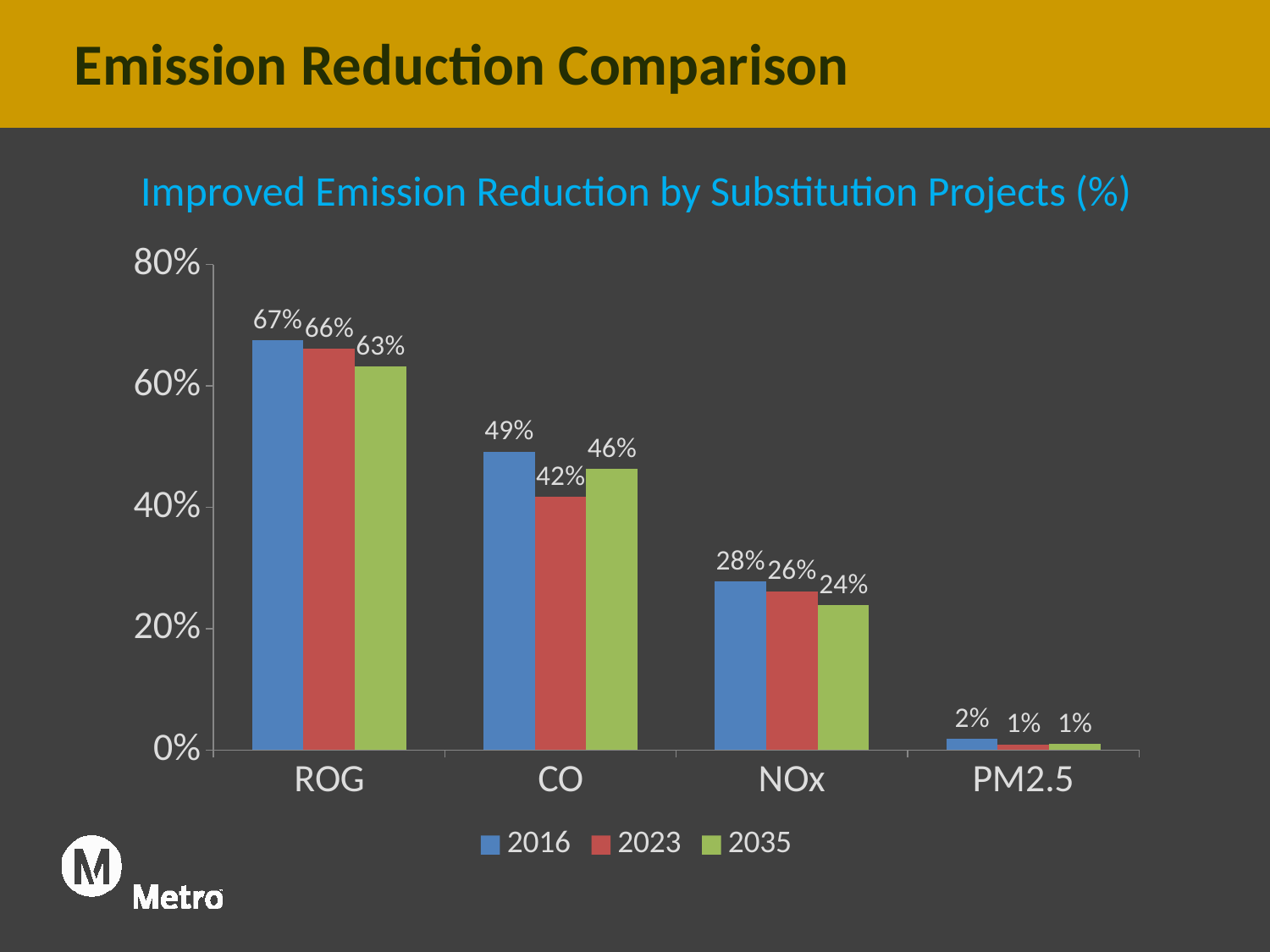
What is the difference between the 2016 and 2023 values for CO? 7% How many series does the legend list? 3 What is the value for CO in the 2023 series? 42% What is the value for NOx in the 2035 series? 24% What is the value for PM2.5 in the 2016 series? 2% How many categories are shown on the x axis? 4 What is the title of the chart? Improved Emission Reduction by Substitution Projects (%) What is the value for ROG in the 2016 series? 67% Which category has the lowest value in the 2035 series? PM2.5 Which is larger for CO: the 2023 value or the 2035 value? 2035 What kind of chart is shown on the slide? Bar chart Which category has the highest value in the 2016 series? ROG